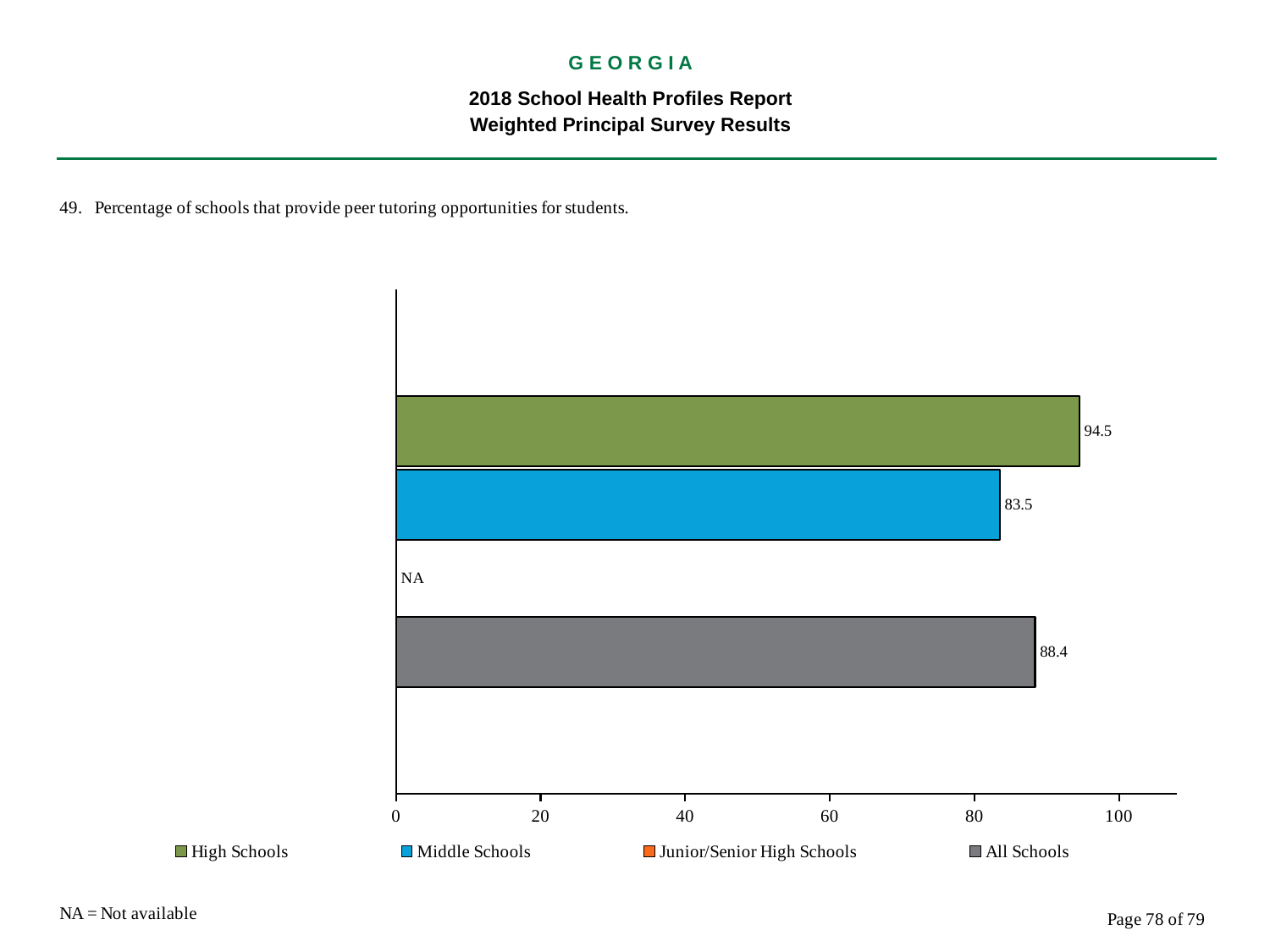
What is the value for Middle Schools? 83.5 Which school type has the highest value? High Schools Is the value for Middle Schools greater or less than 80? greater What is the value for High Schools? 94.5 What kind of chart is shown? bar chart What is the value for All Schools? 88.4 What is the difference between the High Schools and Middle Schools values? 11.0 Which is larger, the value for All Schools or the value for Middle Schools? All Schools Which school type with a plotted bar has the lowest value? Middle Schools How many series does the legend list? 4 What is shown for Junior/Senior High Schools? NA What does NA stand for according to the note on the slide? Not available